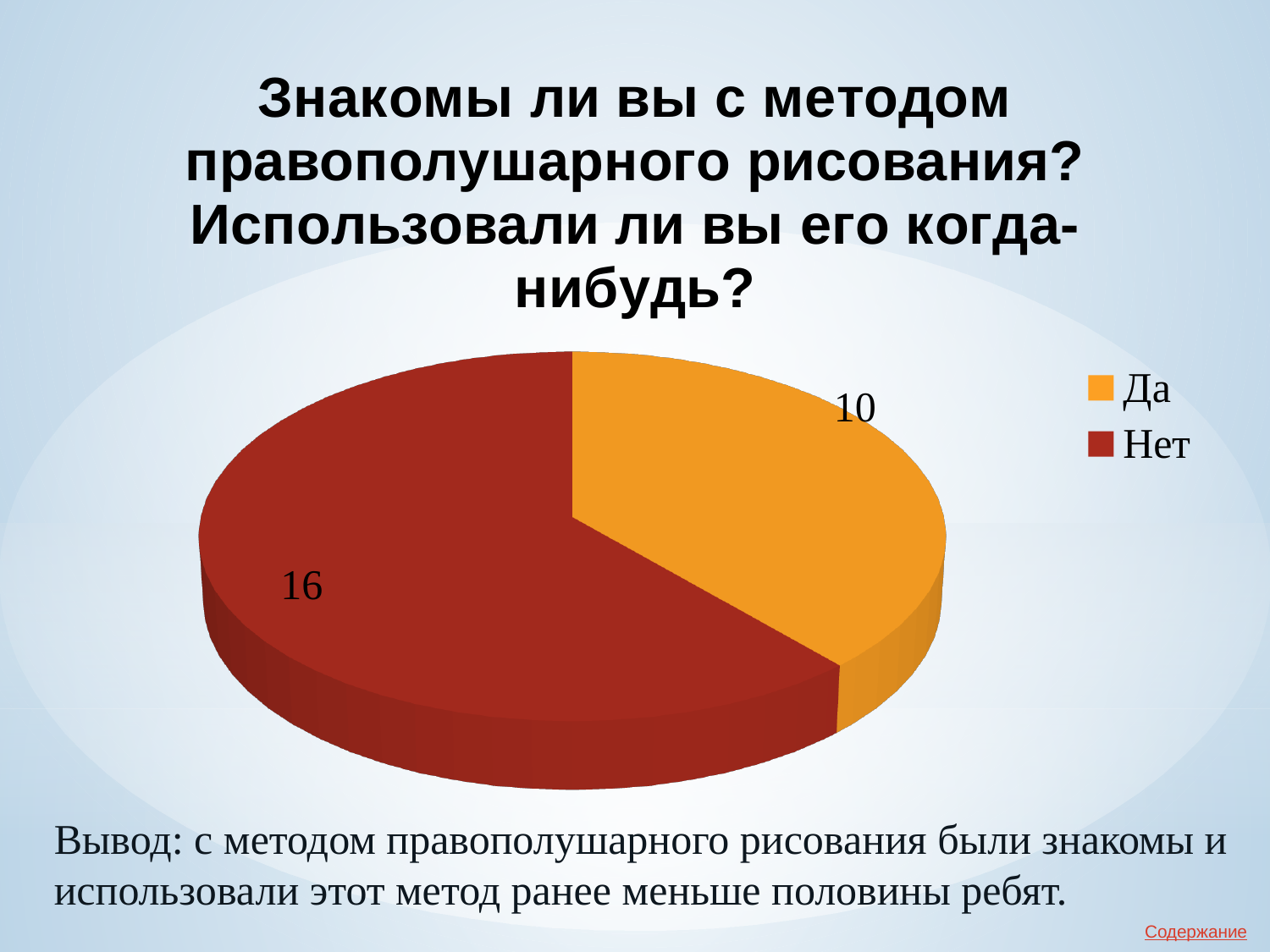
How many categories does the pie chart show? 2 Which is larger, the value for "Да" or the value for "Нет"? Нет Which category has the largest slice in the pie chart? Нет Which category has the smallest slice in the pie chart? Да What is the total of all slices in the pie chart? 26 What kind of chart is shown on the slide? Pie chart What is the value for "Да" in the pie chart? 10 What is the value for "Нет" in the pie chart? 16 What colour is the "Да" slice in the pie chart? Orange What colour is the "Нет" slice in the pie chart? Red What is the difference between the values for "Нет" and "Да"? 6 What share of the pie does the "Да" slice represent, as a fraction of the total? 10/26